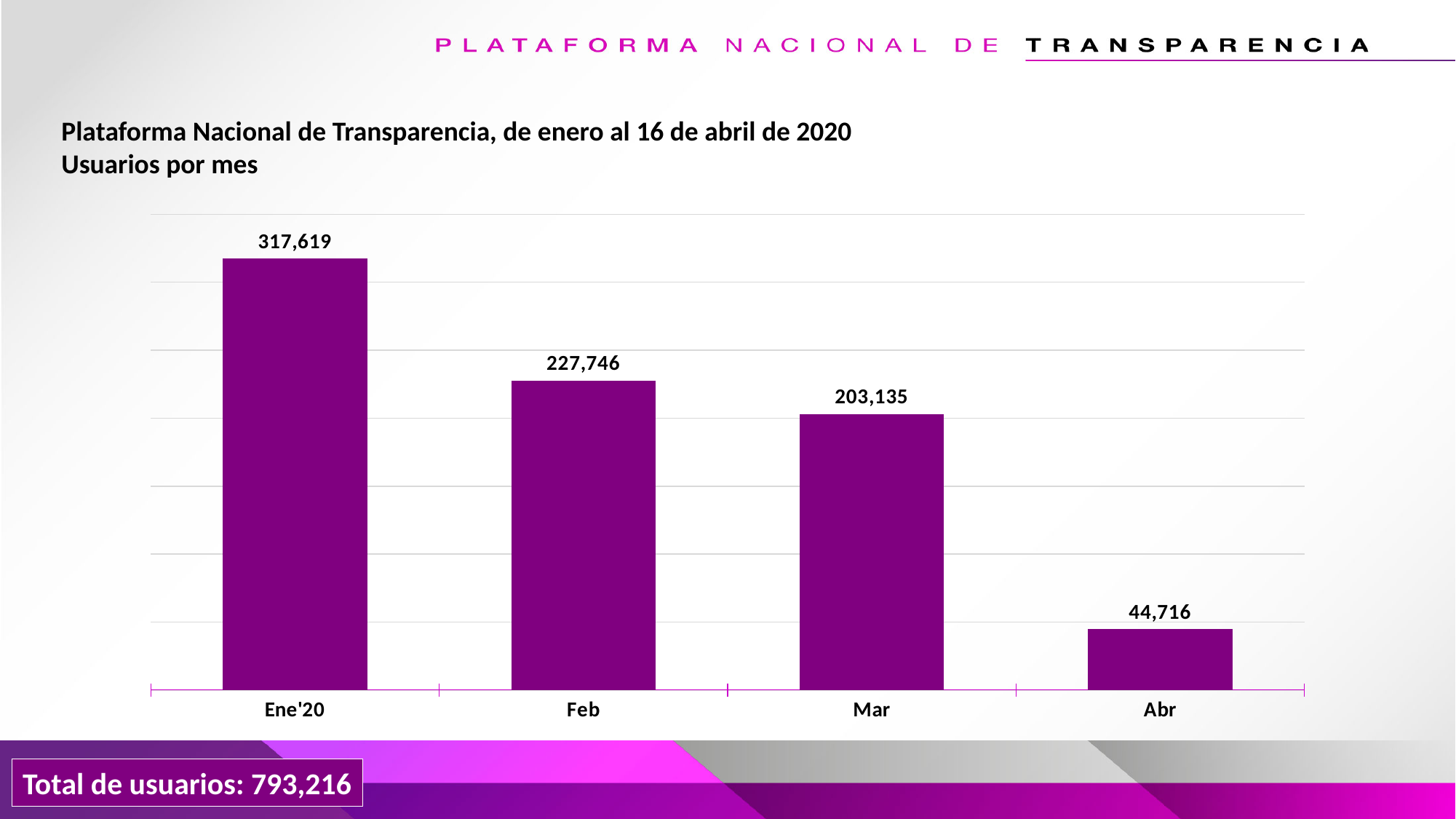
What is the number of users for Abr? 44,716 What kind of chart is shown on the slide? Bar chart Which month has the highest number of users? Ene'20 Which month has the lowest number of users? Abr What is the difference in users between Mar and Abr? 158,419 Which month has more users, Feb or Mar? Feb What is the number of users for Feb? 227,746 What is the number of users for Ene'20? 317,619 What is the number of users for Mar? 203,135 Do the values rise or fall from Ene'20 to Abr? Fall What is the difference in users between Ene'20 and Feb? 89,873 How many months are shown on the chart? 4